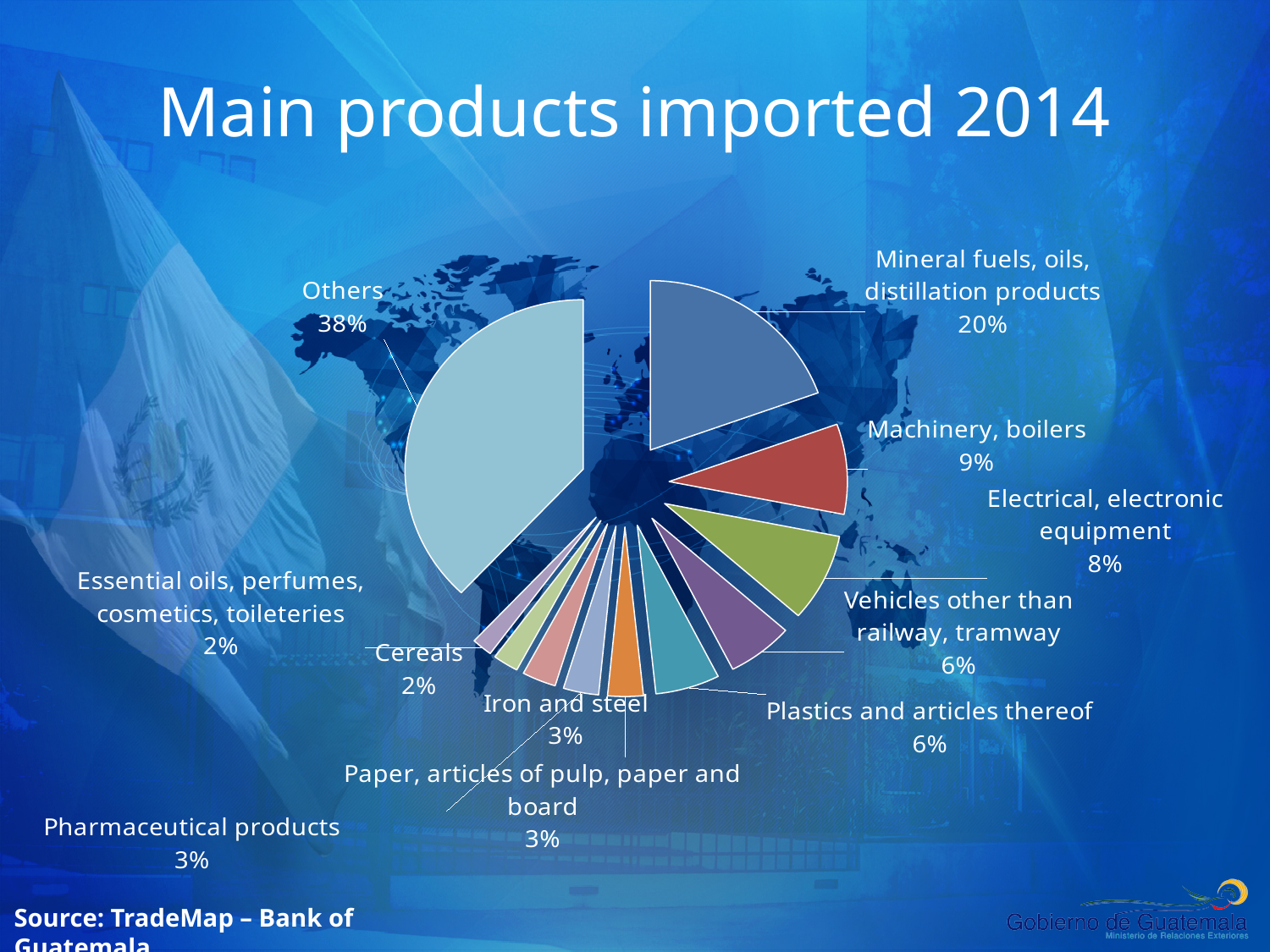
What type of chart is shown on the slide? pie chart What percentage is shown for Machinery, boilers? 9% What percentage is shown for Cereals? 2% What is the title of the chart? Main products imported 2014 What is the difference in percentage points between Others and Mineral fuels, oils, distillation products? 18 What percentage is shown for Electrical, electronic equipment? 8% How many categories are shown in the pie chart? 11 What share of imports is labelled for Mineral fuels, oils, distillation products? 20% What percentage is shown for Pharmaceutical products? 3% What is the difference in percentage points between Vehicles other than railway, tramway and Iron and steel? 3 Which category has the largest slice of the pie? Others Which is larger, the share for Machinery, boilers or the share for Plastics and articles thereof? Machinery, boilers